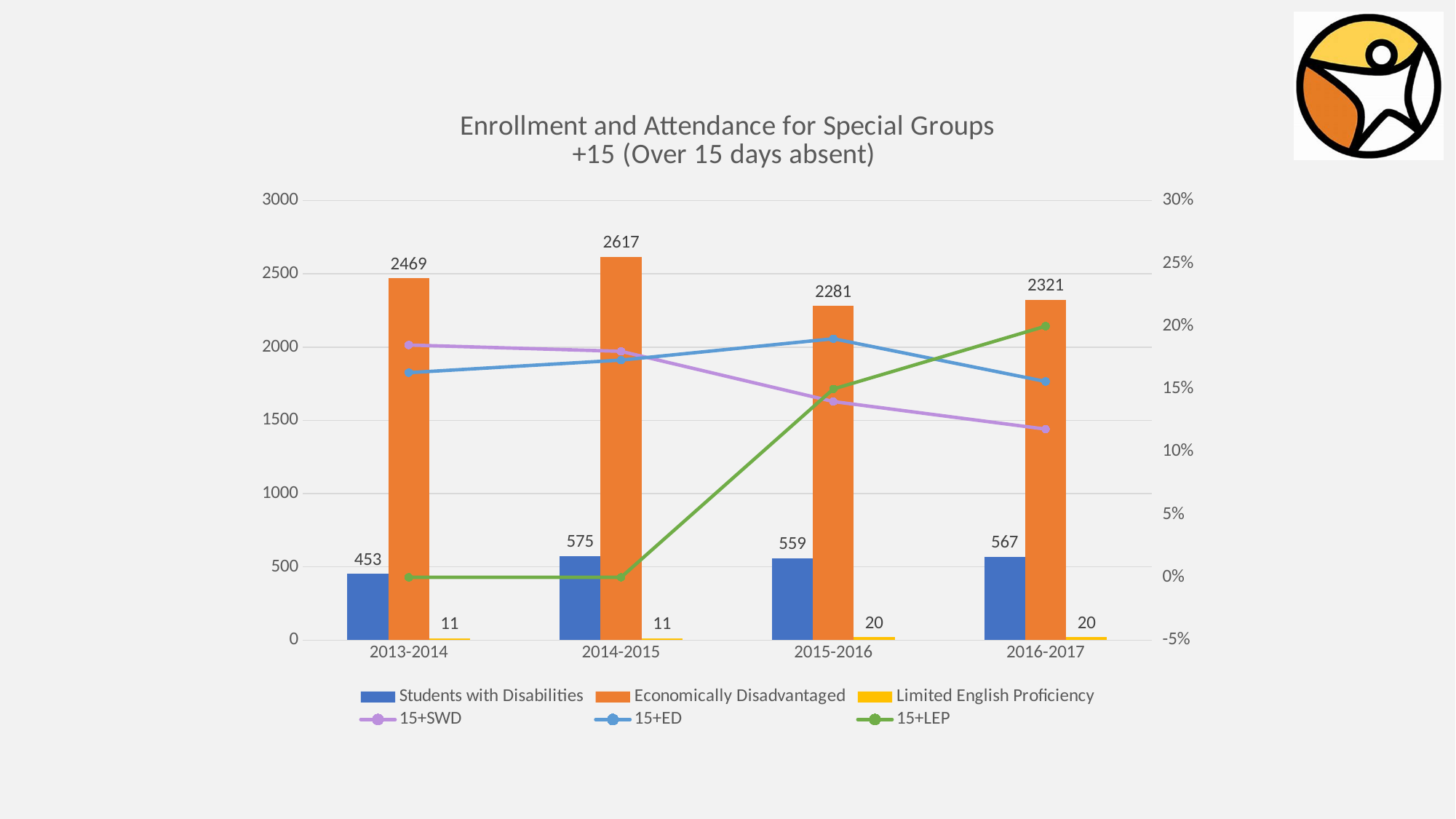
What is the value for Economically Disadvantaged in 2014-2015? 2617 How many school years are shown on the x axis? 4 Does the 15+SWD line rise or fall from 2013-2014 to 2016-2017? fall In which year is the Economically Disadvantaged bar highest? 2014-2015 How many series does the legend list? 6 What is the value for Students with Disabilities in 2013-2014? 453 Is the 15+LEP value for 2016-2017 greater or less than 15%? greater Is the 15+SWD value for 2016-2017 greater or less than 15%? less What is the difference between the Economically Disadvantaged values for 2014-2015 and 2015-2016? 336 In which year is the Students with Disabilities bar lowest? 2013-2014 What is the value for Limited English Proficiency in 2016-2017? 20 Which is larger, Students with Disabilities in 2014-2015 or in 2016-2017? 2014-2015